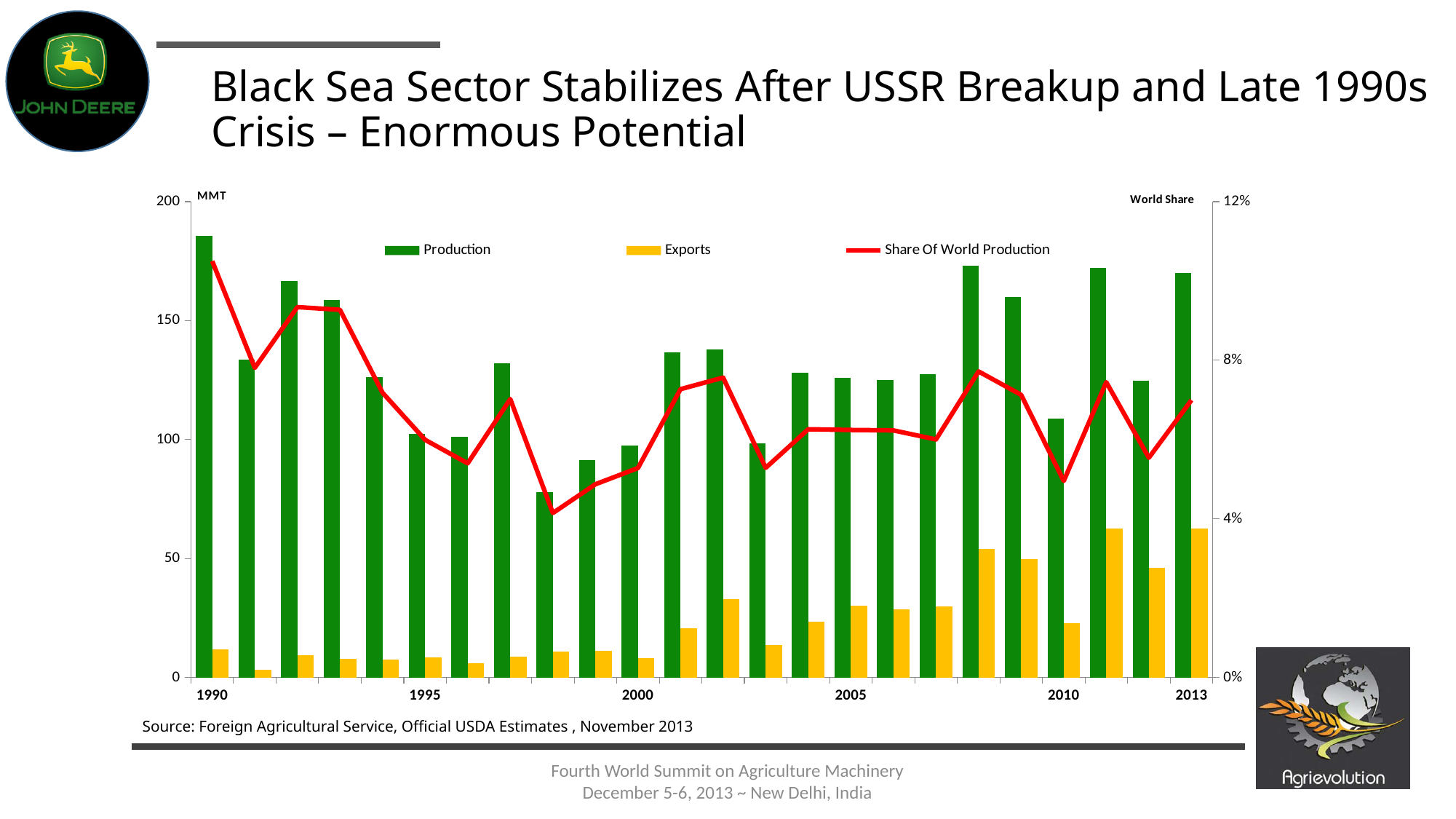
Is the Production value for 2010 greater or less than 150? less Is the Share Of World Production value for 1990 greater or less than 8%? greater What unit is shown at the top of the left axis of the chart? MMT Which year has the highest Production bar? 1990 Is the Exports value for 1990 greater or less than 50? less What are the three series named in the chart legend? Production, Exports, Share Of World Production Which is larger, the Exports value for 2010 or for 2013? 2013 How many series does the chart legend list? 3 What kind of chart is shown on the slide? Bar chart with a line